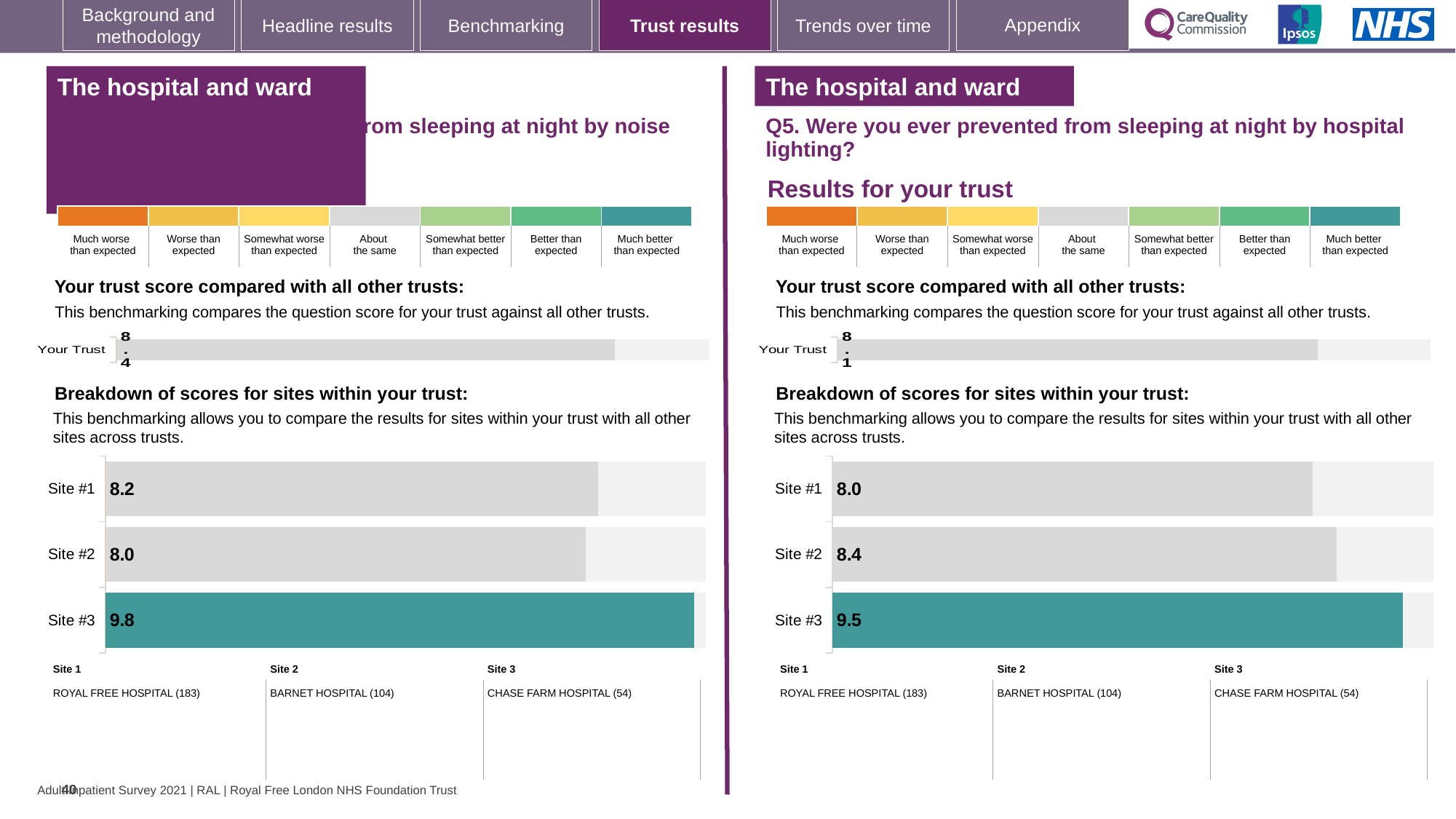
What type of chart is the left-hand site breakdown chart? Bar chart On the left-hand site breakdown chart, what is the score for Site #1? 8.2 On the right-hand (Q5 hospital lighting) site breakdown chart, what is the score for Site #2? 8.4 On the right-hand (Q5 hospital lighting) 'Your trust score compared with all other trusts' chart, what is the score for Your Trust? 8.1 On the left-hand 'Your trust score compared with all other trusts' chart, what is the score for Your Trust? 8.4 On the left-hand site breakdown chart, which site has the highest score? Site #3 On the right-hand (Q5 hospital lighting) site breakdown chart, which site has the lowest score? Site #1 On the left-hand site breakdown chart, what is the difference between the scores for Site #3 and Site #2? 1.8 On the right-hand (Q5 hospital lighting) site breakdown chart, which is larger, the score for Site #1 or Site #2? Site #2 On the left-hand site breakdown chart, what is the score for Site #3? 9.8 On the right-hand (Q5 hospital lighting) site breakdown chart, what is the score for Site #3? 9.5 How many sites are shown on the right-hand (Q5 hospital lighting) site breakdown chart? 3